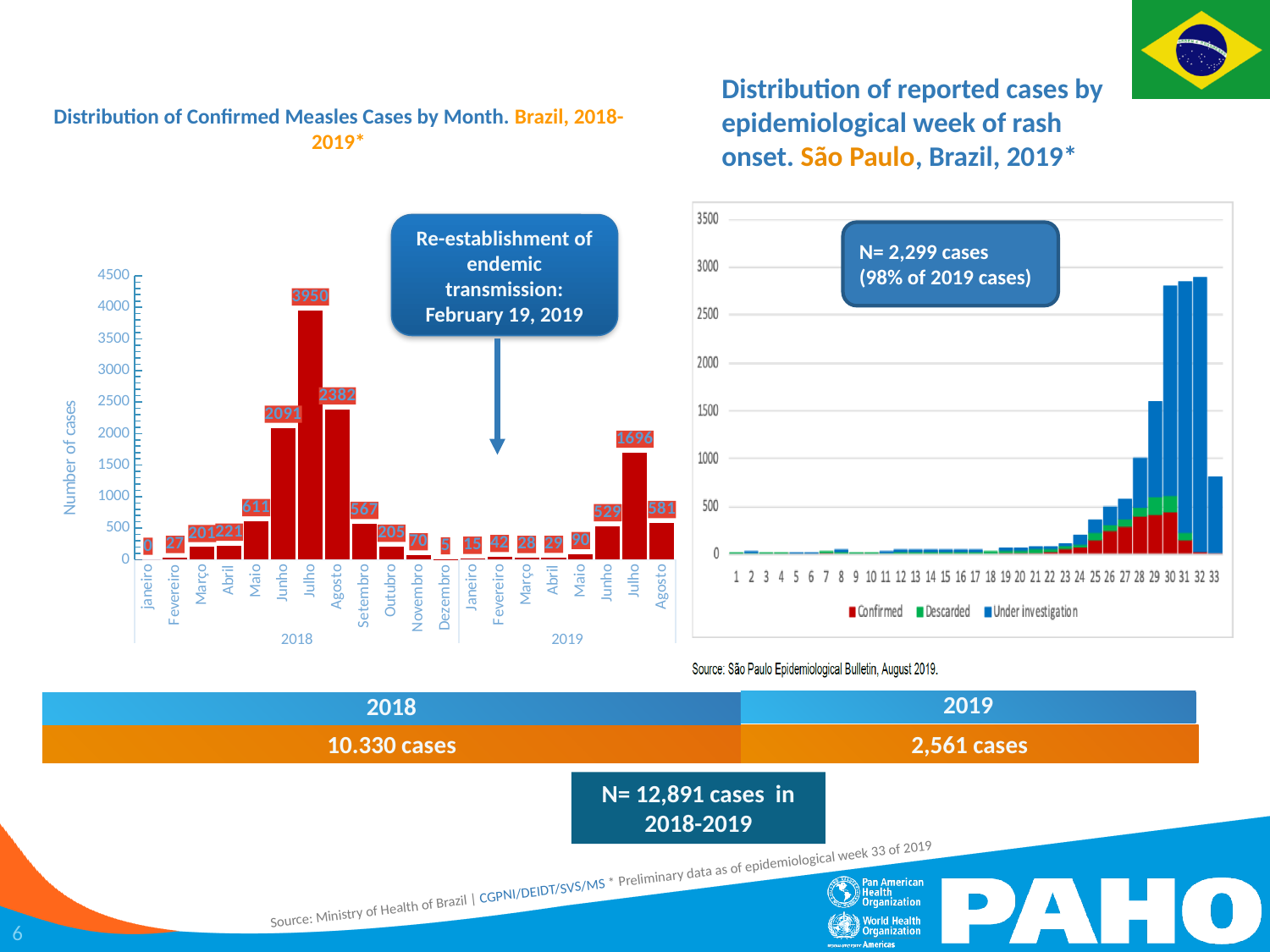
In the left chart (Distribution of Confirmed Measles Cases by Month), how many confirmed cases were reported in Julho 2019? 1696 In the left chart (Distribution of Confirmed Measles Cases by Month), how many months are plotted in total? 20 What kind of chart is the right chart (Distribution of reported cases by epidemiological week of rash onset, São Paulo)? Stacked bar chart In the left chart (Distribution of Confirmed Measles Cases by Month), which month had more confirmed cases, Junho 2018 or Agosto 2018? Agosto 2018 In the right chart (Distribution of reported cases by epidemiological week of rash onset, São Paulo), what are the three legend entries? Confirmed, Descarded, Under investigation In the left chart (Distribution of Confirmed Measles Cases by Month), which month has the highest number of confirmed cases? Julho 2018 How many series does the legend of the right chart (Distribution of reported cases by epidemiological week of rash onset, São Paulo) list? 3 In the left chart (Distribution of Confirmed Measles Cases by Month), what is the difference between the cases in Julho 2018 and Agosto 2018? 1568 In the left chart (Distribution of Confirmed Measles Cases by Month), which month has the lowest number of confirmed cases? Janeiro 2018 In the left chart (Distribution of Confirmed Measles Cases by Month), how many confirmed cases were reported in Julho 2018? 3950 In the right chart (Distribution of reported cases by epidemiological week of rash onset, São Paulo), is the total for week 30 greater or less than 2500? greater In the left chart (Distribution of Confirmed Measles Cases by Month), how many confirmed cases were reported in Maio 2019? 90